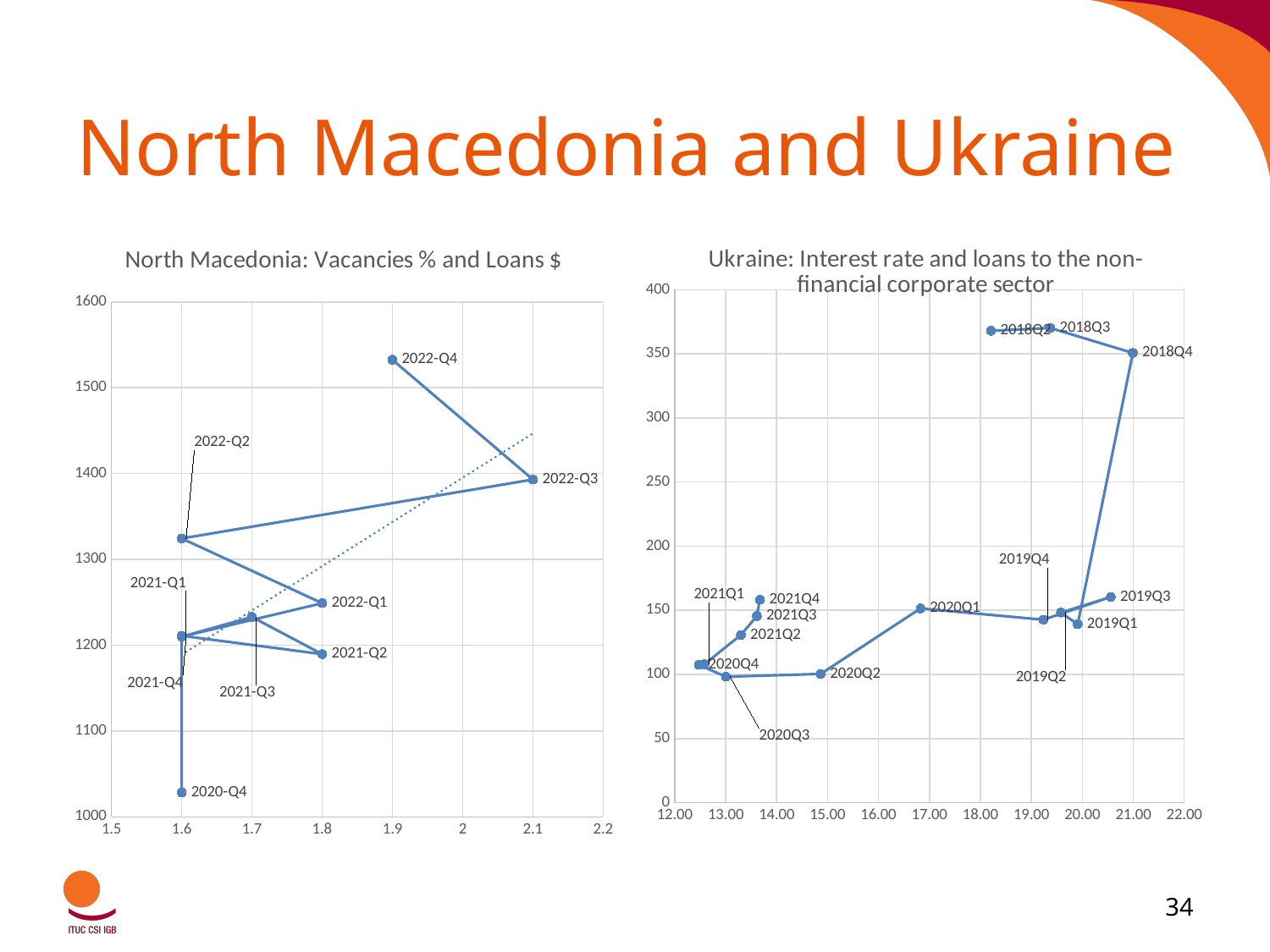
On the Ukraine chart, is the vertical-axis value for 2020Q3 greater or less than 150? less On the Ukraine chart, which labelled quarter lies furthest to the right on the horizontal axis? 2018Q4 What kind of chart is the Ukraine chart on the right of the slide? Scatter chart On the North Macedonia chart, is the vertical-axis value for 2020-Q4 greater or less than 1100? less On the North Macedonia chart, is the vertical-axis value for 2022-Q2 greater or less than 1300? greater On the North Macedonia chart, which labelled quarter lies furthest to the right on the horizontal axis? 2022-Q3 On the North Macedonia chart, which labelled quarter has the highest value on the vertical axis? 2022-Q4 How many labelled data points are plotted on the North Macedonia chart? 9 On the Ukraine chart, which has the higher vertical-axis value, 2018Q4 or 2019Q1? 2018Q4 On the North Macedonia chart, which labelled quarter has the lowest value on the vertical axis? 2020-Q4